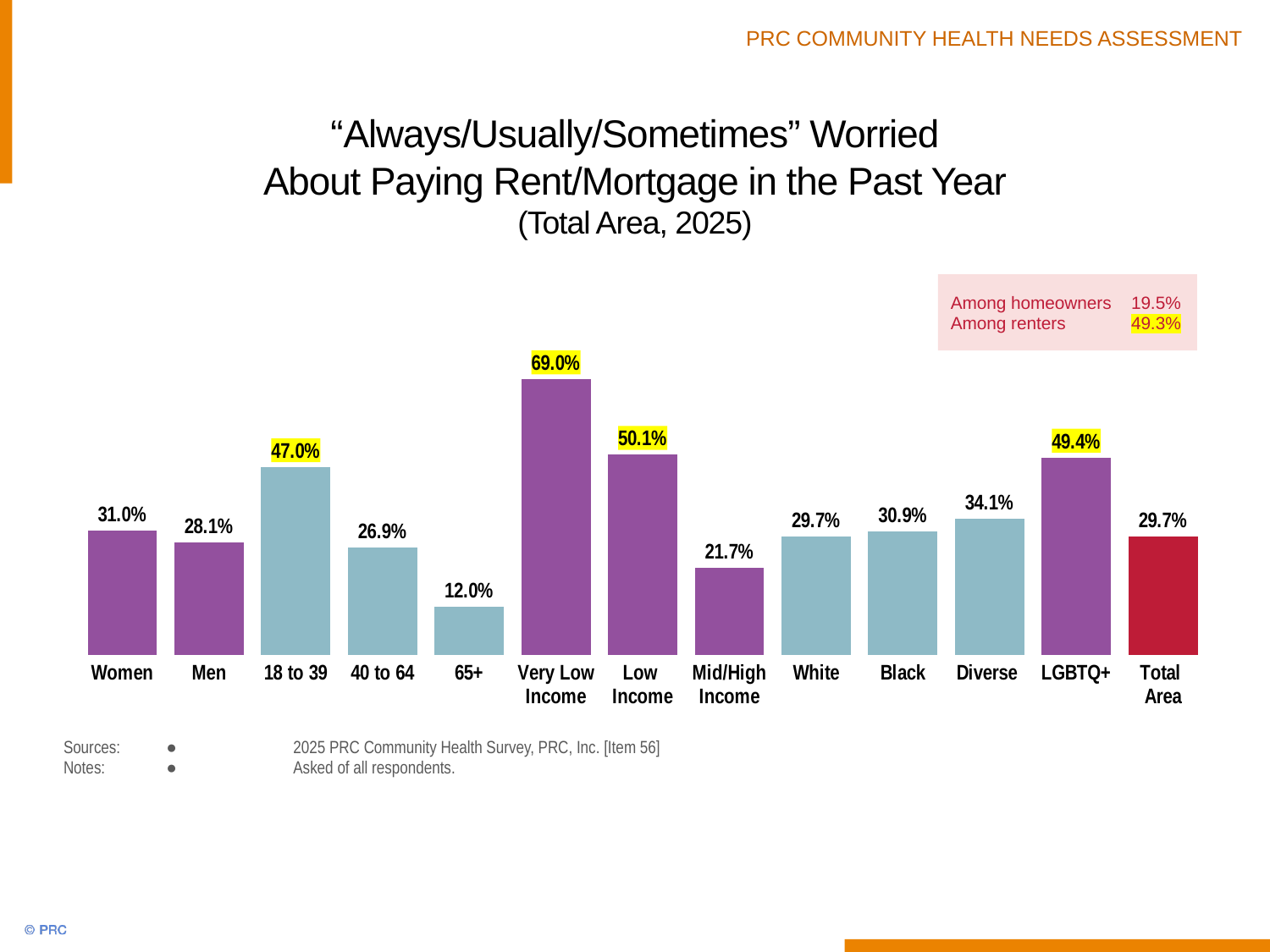
What is the value for Total Area? 29.7% What is the difference between the values for 18 to 39 and 65+? 35.0% What is the value for Very Low Income? 69.0% What is the value for Women? 31.0% According to the box on the slide, what is the value among renters? 49.3% What is the difference between the values for Very Low Income and Low Income? 18.9% How many categories are shown on the x axis? 13 What is the value for LGBTQ+? 49.4% What kind of chart is shown on the slide? Bar chart Which category has the highest value? Very Low Income Which category has the lowest value? 65+ Which is larger, the value for Diverse or the value for Black? Diverse